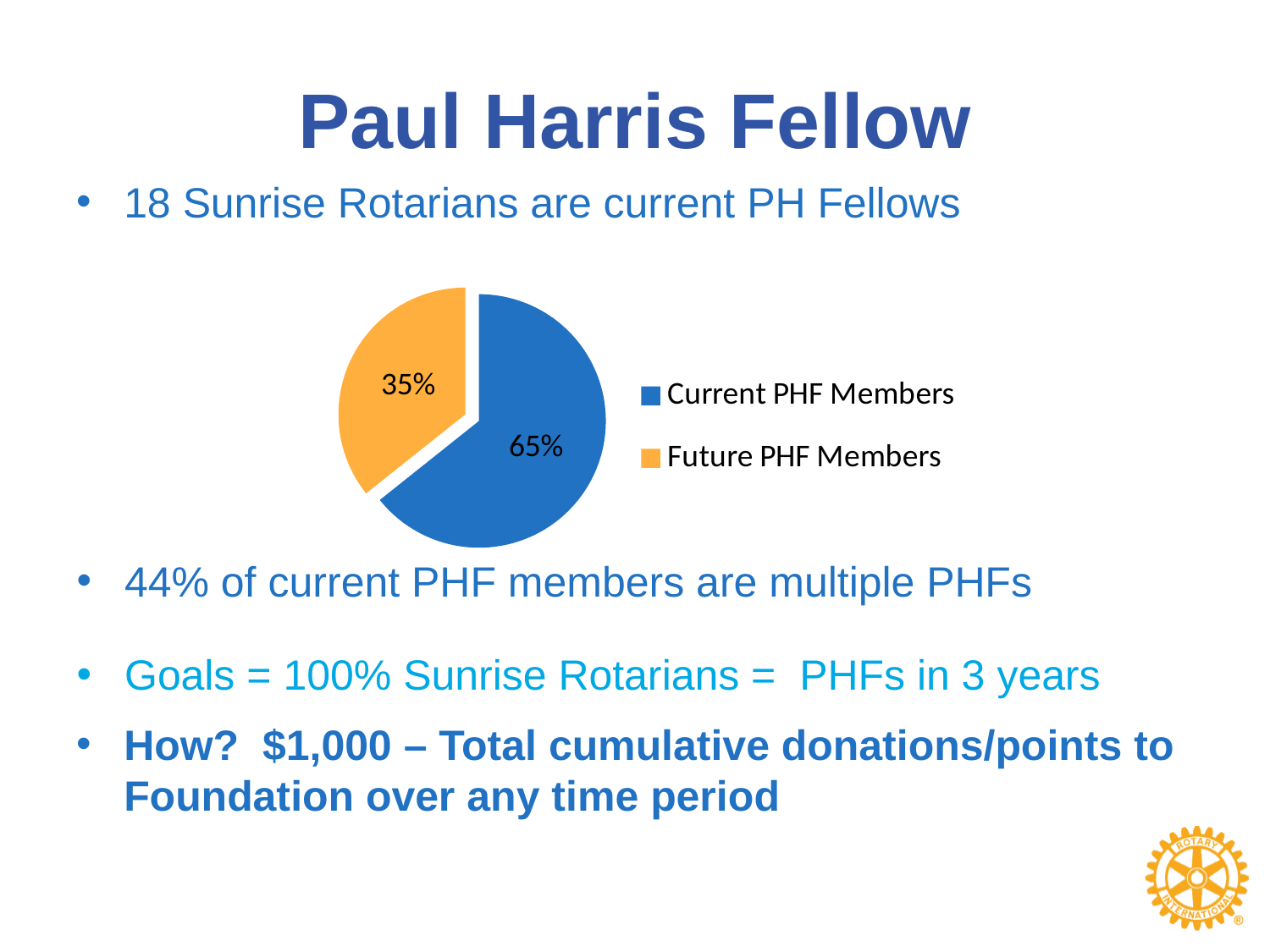
What colour is the Future PHF Members slice? orange How many entries does the legend list? 2 How many slices does the pie chart have? 2 What colour is the Current PHF Members slice? blue What share of the pie is Current PHF Members? 65% What is the difference in percentage points between the Current PHF Members slice and the Future PHF Members slice? 30 Which slice of the pie is the smallest? Future PHF Members What share of the pie is Future PHF Members? 35% Which is larger, the Current PHF Members slice or the Future PHF Members slice? Current PHF Members Which slice of the pie is the largest? Current PHF Members What type of chart is shown on the slide? pie chart